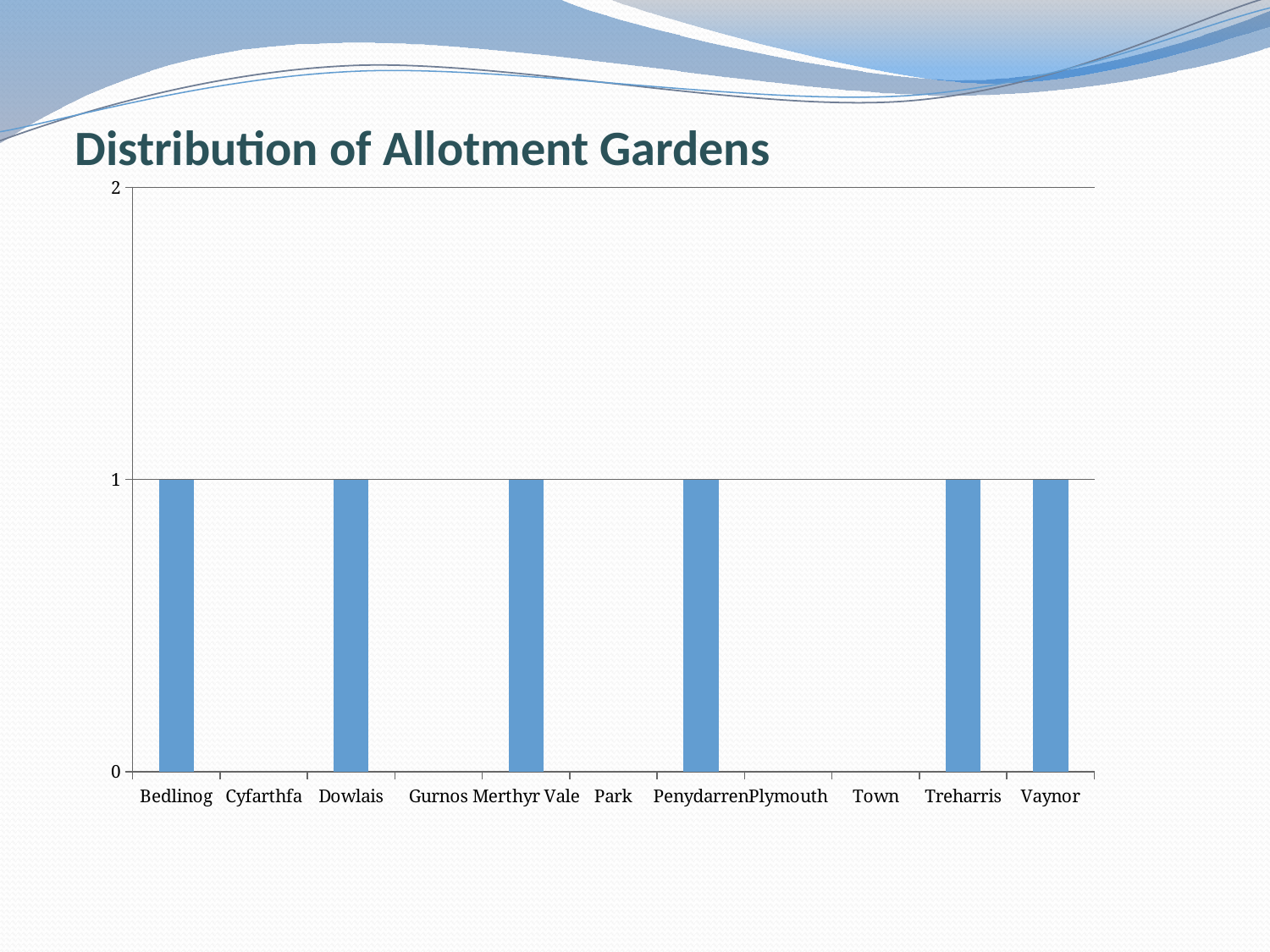
What is the title shown above the chart? Distribution of Allotment Gardens Which is larger, the value for Treharris or the value for Town? Treharris What is the value for Vaynor? 1 Is the value for Bedlinog greater or less than 2? less What is the value for Dowlais? 1 What is the value for Park? 0 Which is larger, the value for Plymouth or the value for Penydarren? Penydarren What kind of chart is shown on the slide? Bar chart What is the value for Bedlinog? 1 How many categories are shown on the x axis of the chart? 11 What is the value for Cyfarthfa? 0 What is the difference between the value for Merthyr Vale and the value for Gurnos? 1